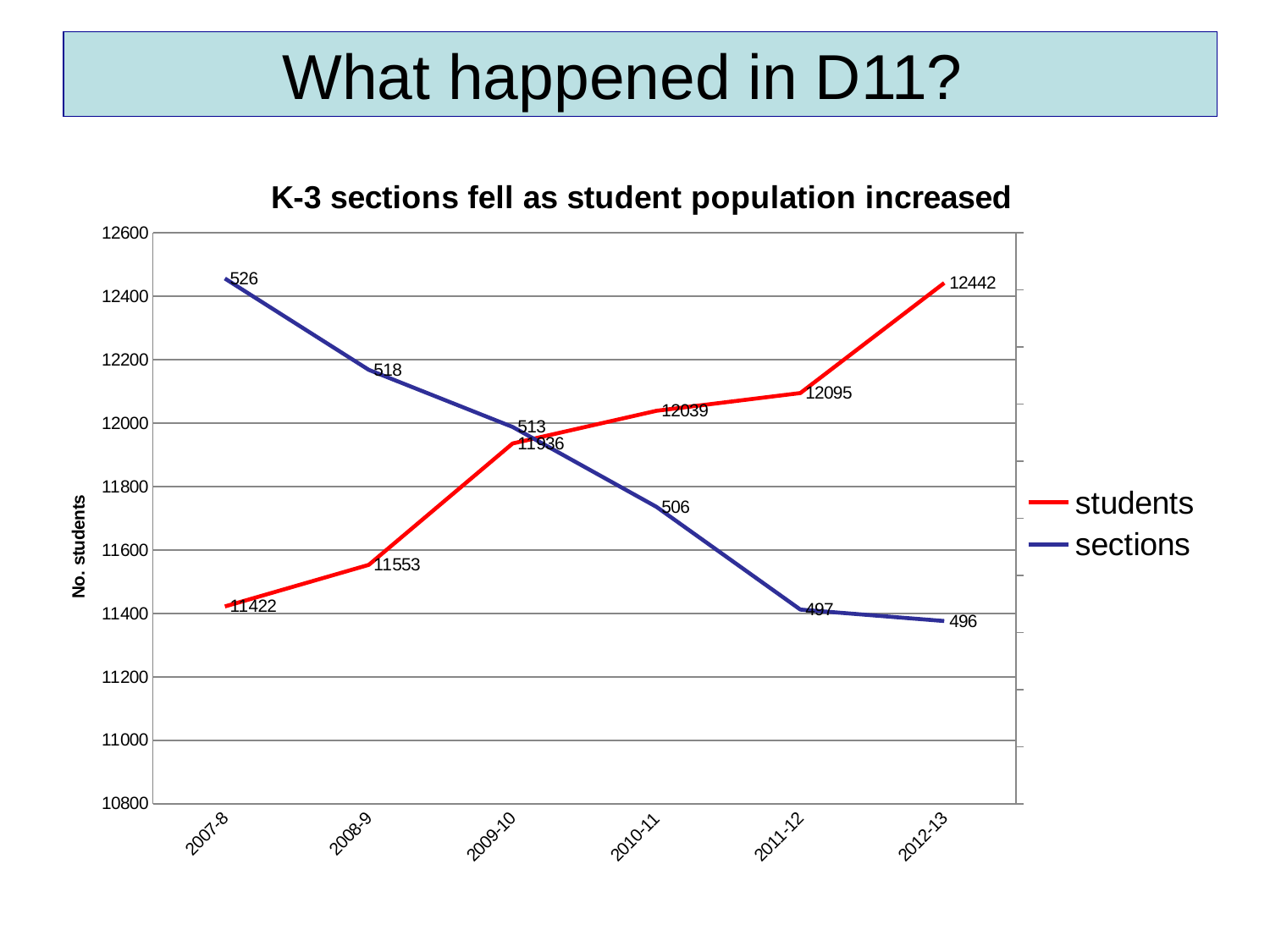
In which school year is the number of students highest? 2012-13 What is the difference in the number of sections between 2007-8 and 2011-12? 29 What is the number of sections in 2010-11? 506 Does the students series rise or fall from 2007-8 to 2012-13? rise What is the title of the chart? K-3 sections fell as student population increased In which school year is the number of sections lowest? 2012-13 Which series is drawn in red? students By how much did the number of students increase from 2007-8 to 2012-13? 1020 How many series does the legend list? 2 How many school years are plotted along the x axis? 6 What kind of chart is shown on the slide? line chart What is the number of students in 2009-10? 11936